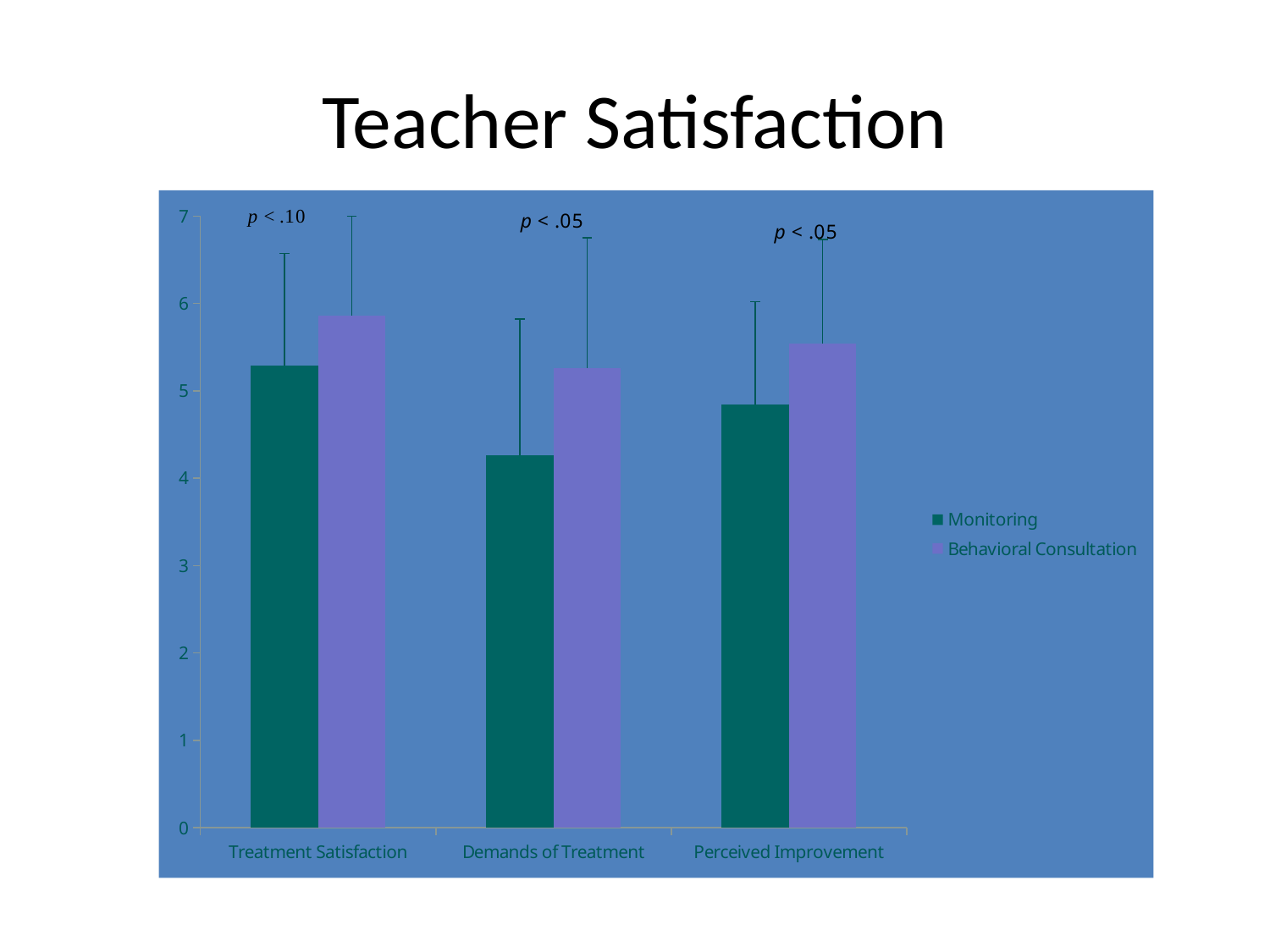
Which category has the lowest Behavioral Consultation value? Demands of Treatment For Perceived Improvement, which series has the larger value, Monitoring or Behavioral Consultation? Behavioral Consultation What is the title of the chart? Teacher Satisfaction Is the Monitoring value for Demands of Treatment greater or less than 5? less Is the Behavioral Consultation value for Treatment Satisfaction greater or less than 6? less Is the Behavioral Consultation value for Perceived Improvement greater or less than 5? greater How many series does the legend list? 2 Which category has the highest Monitoring value? Treatment Satisfaction How many categories are shown on the x axis? 3 Which category has the lowest Monitoring value? Demands of Treatment What kind of chart is shown on the slide? bar chart For Demands of Treatment, which series has the larger value, Monitoring or Behavioral Consultation? Behavioral Consultation